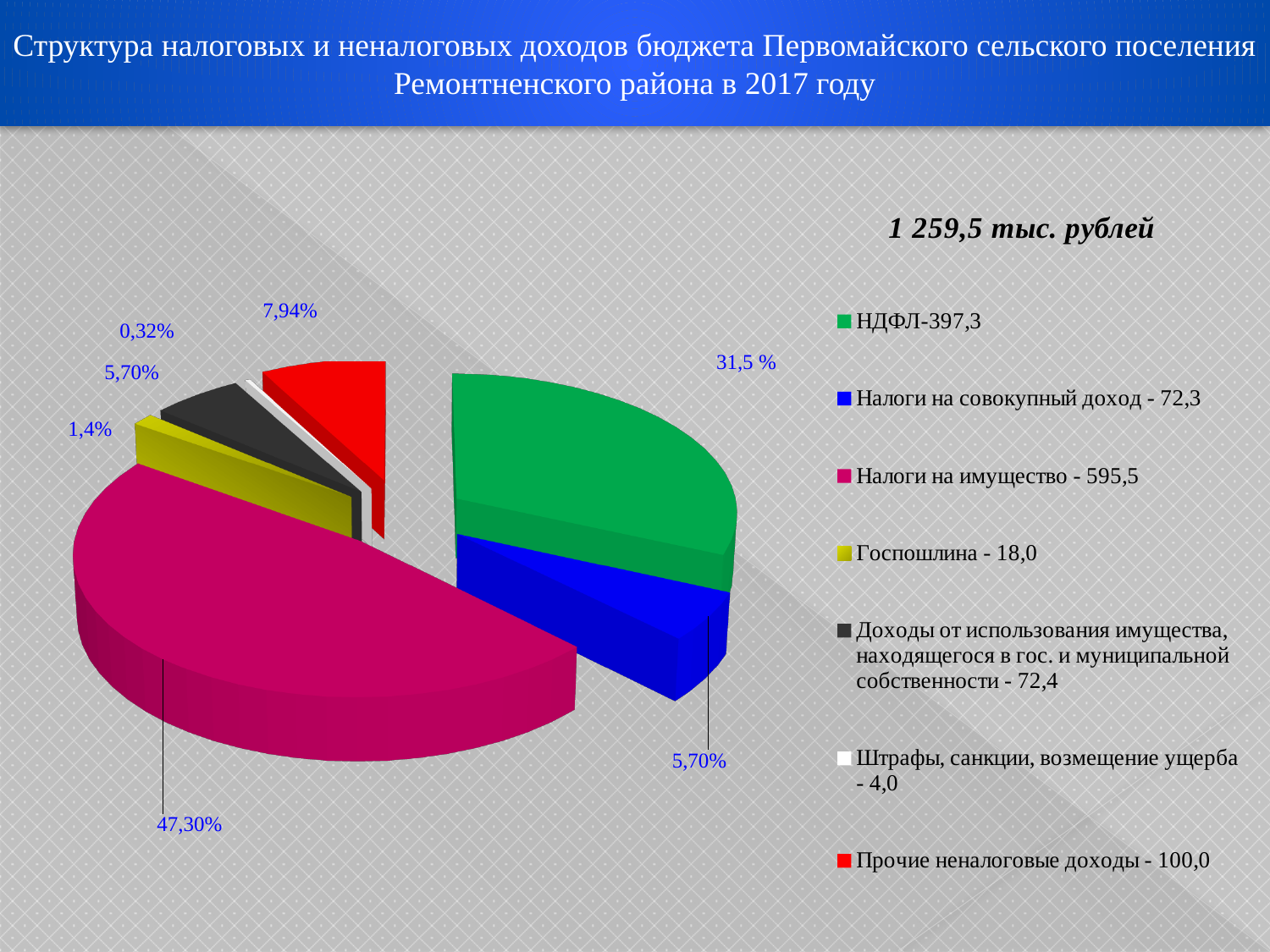
What share of the pie does Прочие неналоговые доходы represent? 7,94% What is the value for Налоги на имущество in the legend? 595,5 What is the difference between the values for Налоги на имущество and НДФЛ? 198,2 Which category has the smallest value? Штрафы, санкции, возмещение ущерба What is the value for НДФЛ in the legend? 397,3 What total amount is shown above the legend? 1 259,5 тыс. рублей What share of the pie does Налоги на имущество represent? 47,30% Which is larger, the value for НДФЛ or the value for Прочие неналоговые доходы? НДФЛ Which category has the largest value? Налоги на имущество What kind of chart is shown on the slide? Pie chart What is the value for Госпошлина in the legend? 18,0 How many categories does the pie chart have? 7